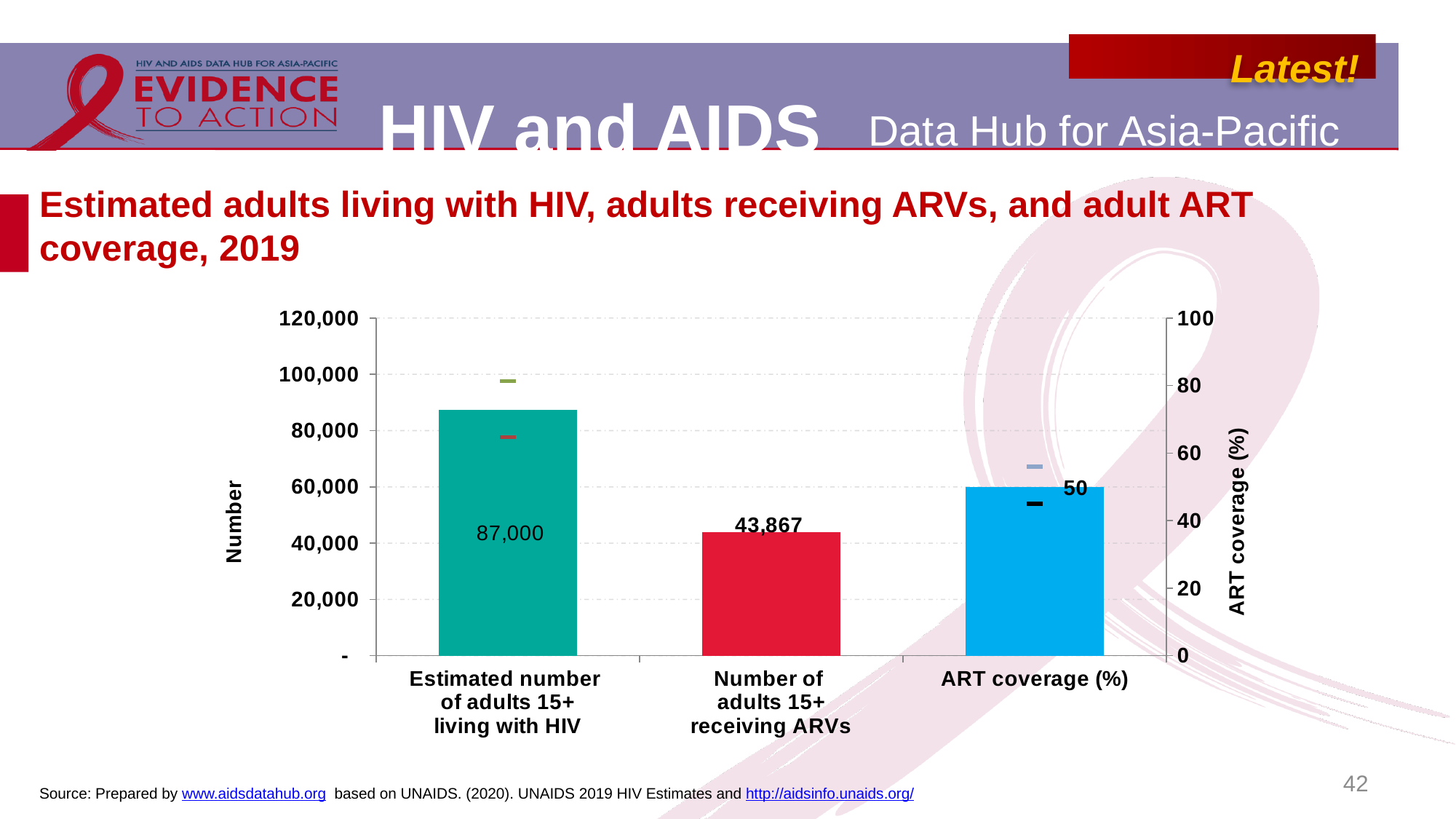
What is the estimated number of adults 15+ living with HIV shown on the chart? 87,000 What kind of chart is shown on the slide? Bar chart What is the label of the right-hand vertical axis of the chart? ART coverage (%) What is the number of adults 15+ receiving ARVs shown on the chart? 43,867 Is the estimated number of adults 15+ living with HIV greater or less than 80,000? greater Is the ART coverage (%) value greater or less than 40? greater What is the difference between the estimated number of adults 15+ living with HIV and the number of adults 15+ receiving ARVs? 43,133 What is the ART coverage (%) value shown on the chart? 50 How many bars are plotted on the chart? 3 Is the number of adults 15+ receiving ARVs greater or less than 60,000? less Which category has the tallest bar on the chart? Estimated number of adults 15+ living with HIV Which is larger: the estimated number of adults 15+ living with HIV or the number of adults 15+ receiving ARVs? Estimated number of adults 15+ living with HIV